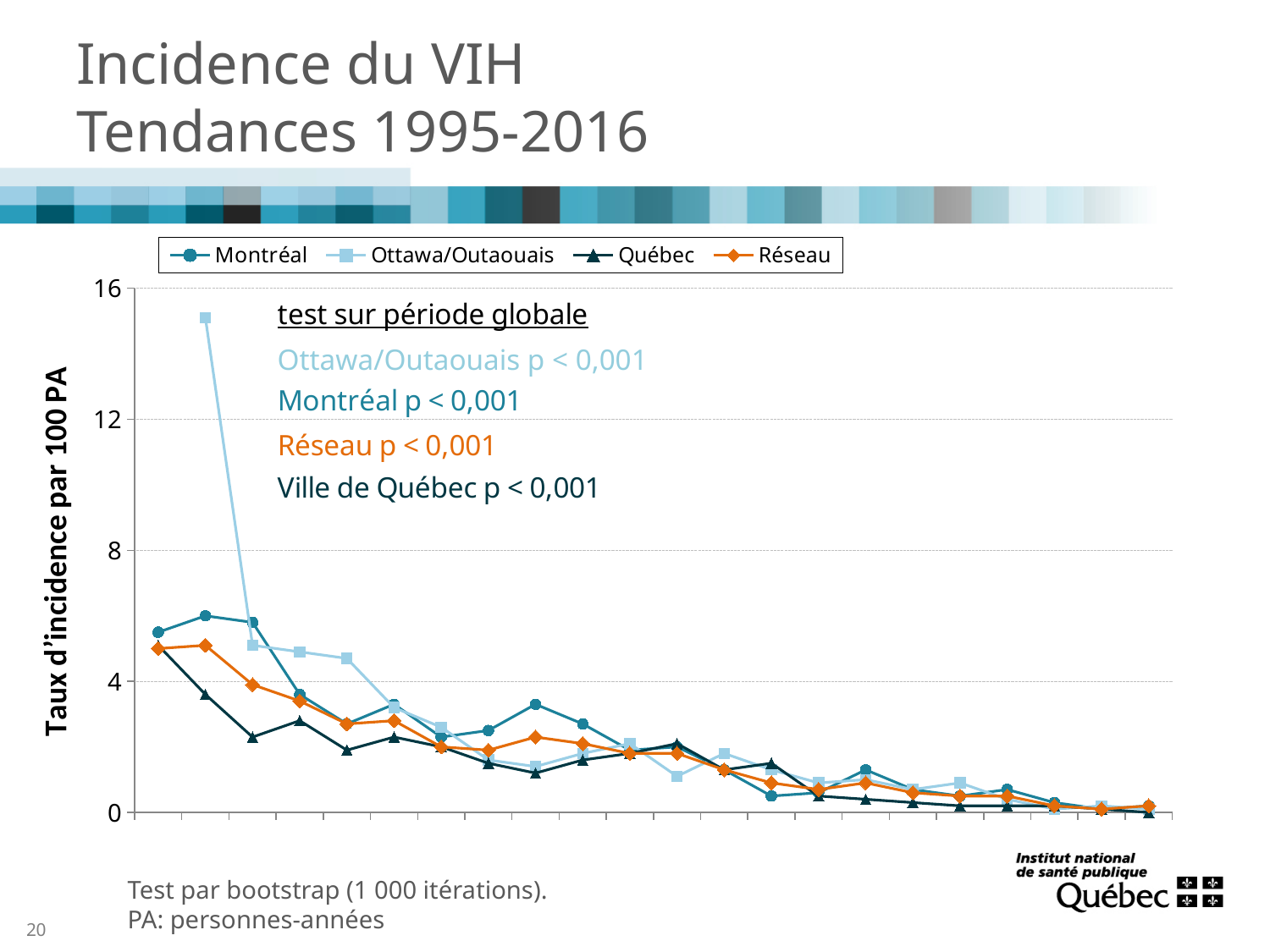
Is the first plotted value for Québec greater or less than 4? greater Which series reaches the highest value on the chart? Ottawa/Outaouais Which series is drawn in orange with diamond markers? Réseau Which is larger, the highest value for Ottawa/Outaouais or the highest value for Montréal? Ottawa/Outaouais Is the last plotted value for Réseau greater or less than 4? less What is the title of the y axis? Taux d'incidence par 100 PA What kind of chart is shown on the slide? line chart How many series does the legend list? 4 Do the values for Montréal generally rise or fall along the x axis? fall Is the first plotted value for Montréal greater or less than 4? greater Do the values for Réseau generally rise or fall along the x axis? fall